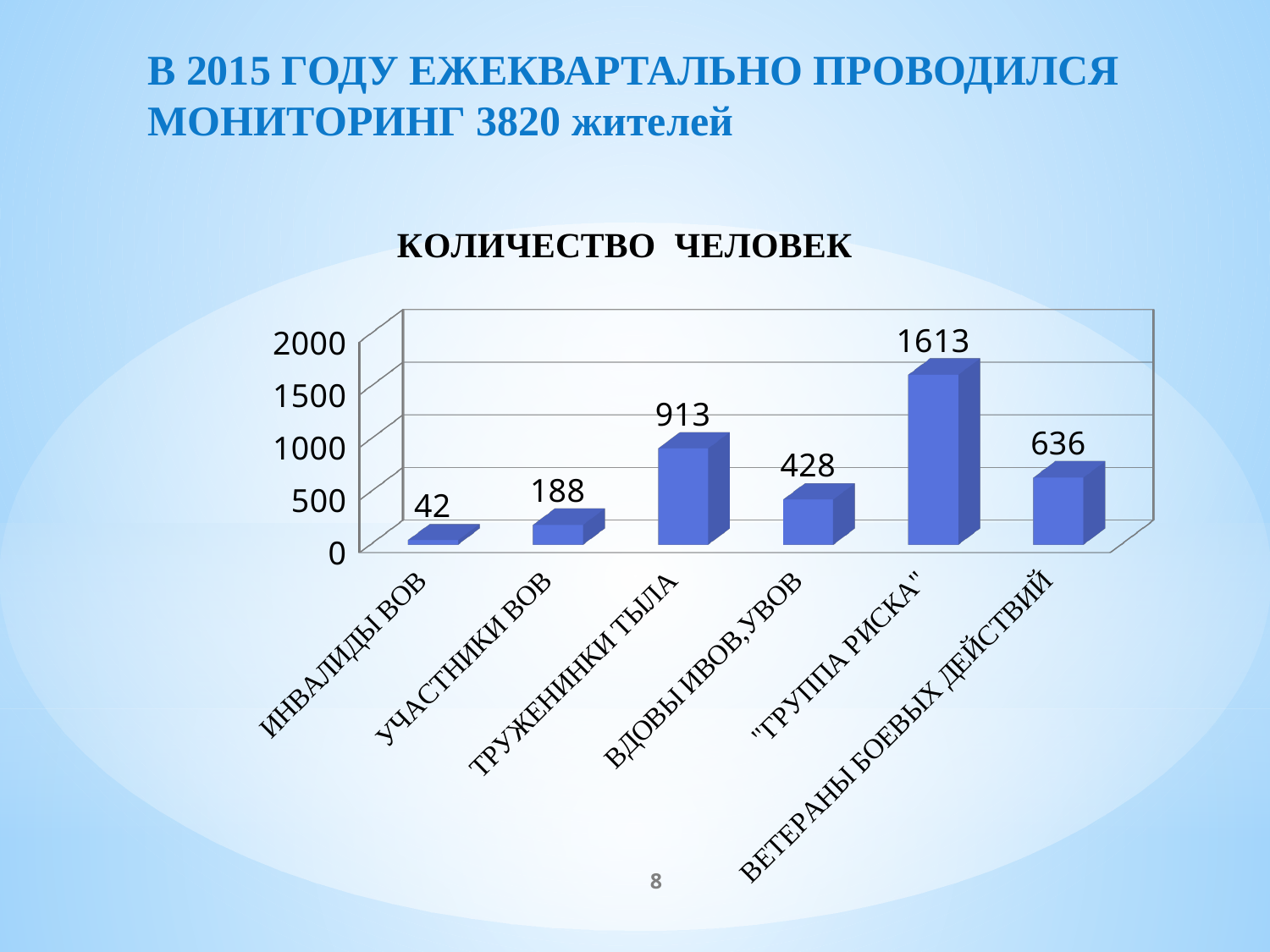
What is the value for ТРУЖЕНИНКИ ТЫЛА? 913 What is the difference between the values for "ГРУППА РИСКА" and ТРУЖЕНИНКИ ТЫЛА? 700 How many categories are shown on the chart? 6 Which category has the highest value? "ГРУППА РИСКА" Is the value for "ГРУППА РИСКА" greater or less than 1500? greater What is the value for ВДОВЫ ИВОВ,УВОВ? 428 What kind of chart is shown on the slide? bar chart What is the difference between the values for УЧАСТНИКИ ВОВ and ИНВАЛИДЫ ВОВ? 146 What is the title of the chart? КОЛИЧЕСТВО ЧЕЛОВЕК Which category has the lowest value? ИНВАЛИДЫ ВОВ What is the value for ВЕТЕРАНЫ БОЕВЫХ ДЕЙСТВИЙ? 636 Which is larger, the value for ВЕТЕРАНЫ БОЕВЫХ ДЕЙСТВИЙ or the value for ВДОВЫ ИВОВ,УВОВ? ВЕТЕРАНЫ БОЕВЫХ ДЕЙСТВИЙ